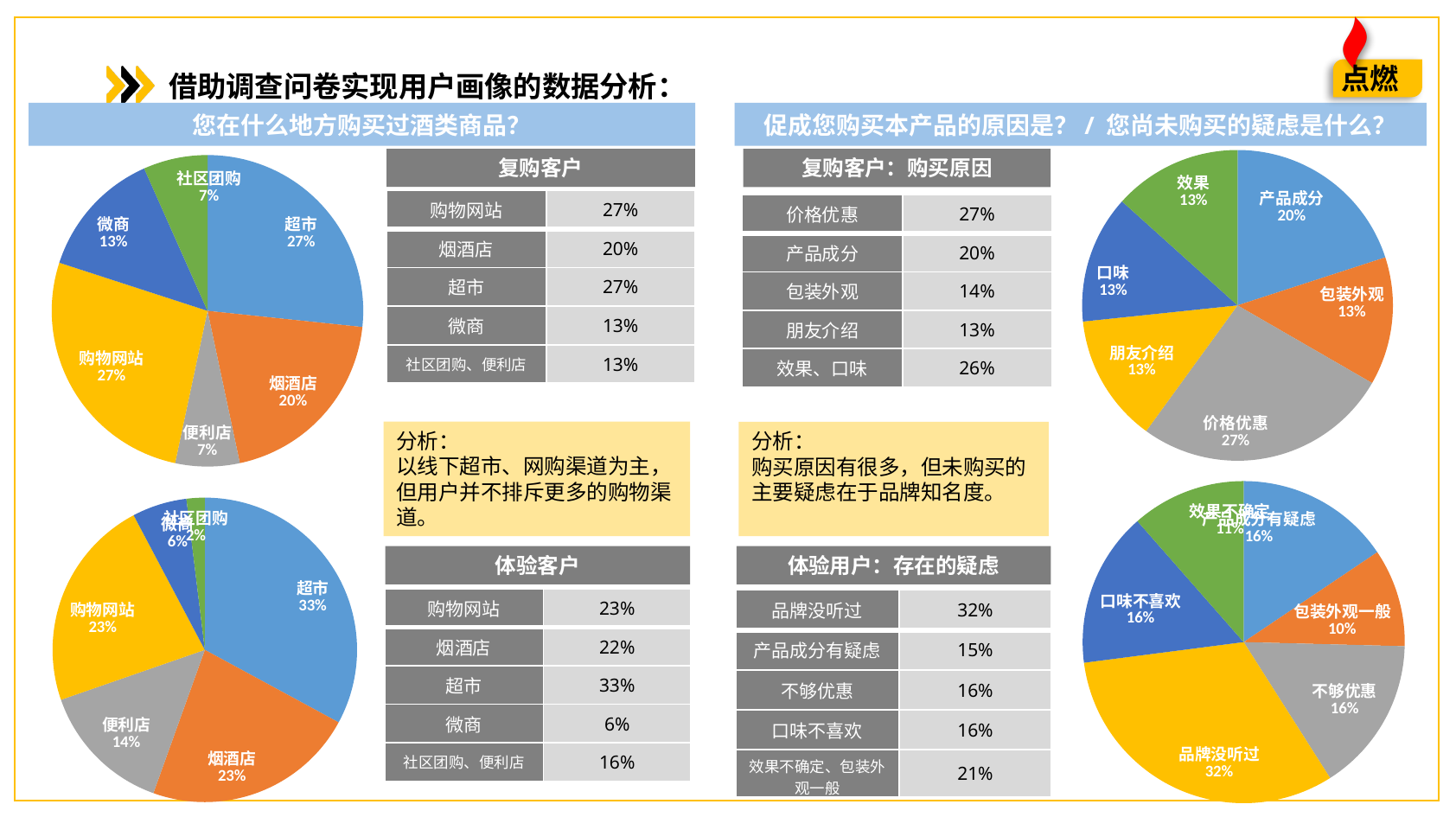
In the top-right pie chart, which category has the largest share? 价格优惠 In the bottom-left pie chart, what is the difference between the shares of 超市 and 便利店? 19% In the top-left pie chart, which category has the smallest share, 烟酒店 or 便利店? 便利店 In the bottom-left pie chart, which category has the largest share? 超市 In the top-right pie chart, what share is labelled for 产品成分? 20% What type of chart is the bottom-right chart? pie chart How many slices does the top-left pie chart have? 6 In the bottom-right pie chart, what share is labelled for 品牌没听过? 32% In the top-left pie chart, what share is labelled for 超市? 27% In the bottom-right pie chart, which category has the smallest share? 包装外观一般 In the bottom-left pie chart, which category has the smallest share? 社区团购 In the top-left pie chart, what share is labelled for 微商? 13%